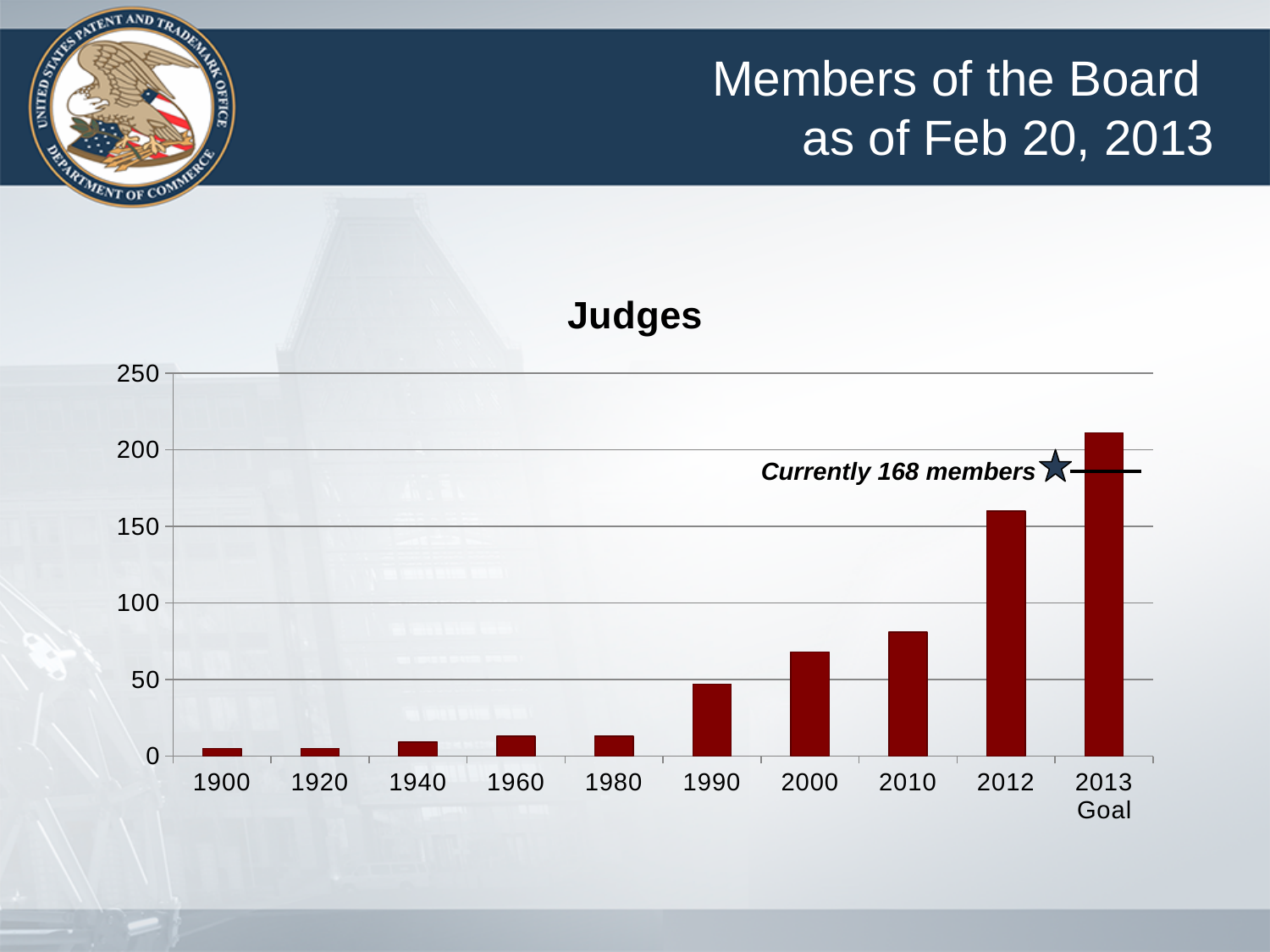
Which is larger, the value for 2010 or the value for 2012? 2012 What is the title of the chart? Judges Which category has the highest bar in the chart? 2013 Goal Is the value for 2000 greater or less than 50? greater How many categories are shown along the x axis of the chart? 10 What kind of chart is shown on the slide? bar chart Is the value for 2013 Goal greater or less than 200? greater Do the values generally rise or fall from 1900 to 2013 Goal? rise According to the annotation on the chart, how many members are there currently? 168 members Is the value for 2012 greater or less than 150? greater